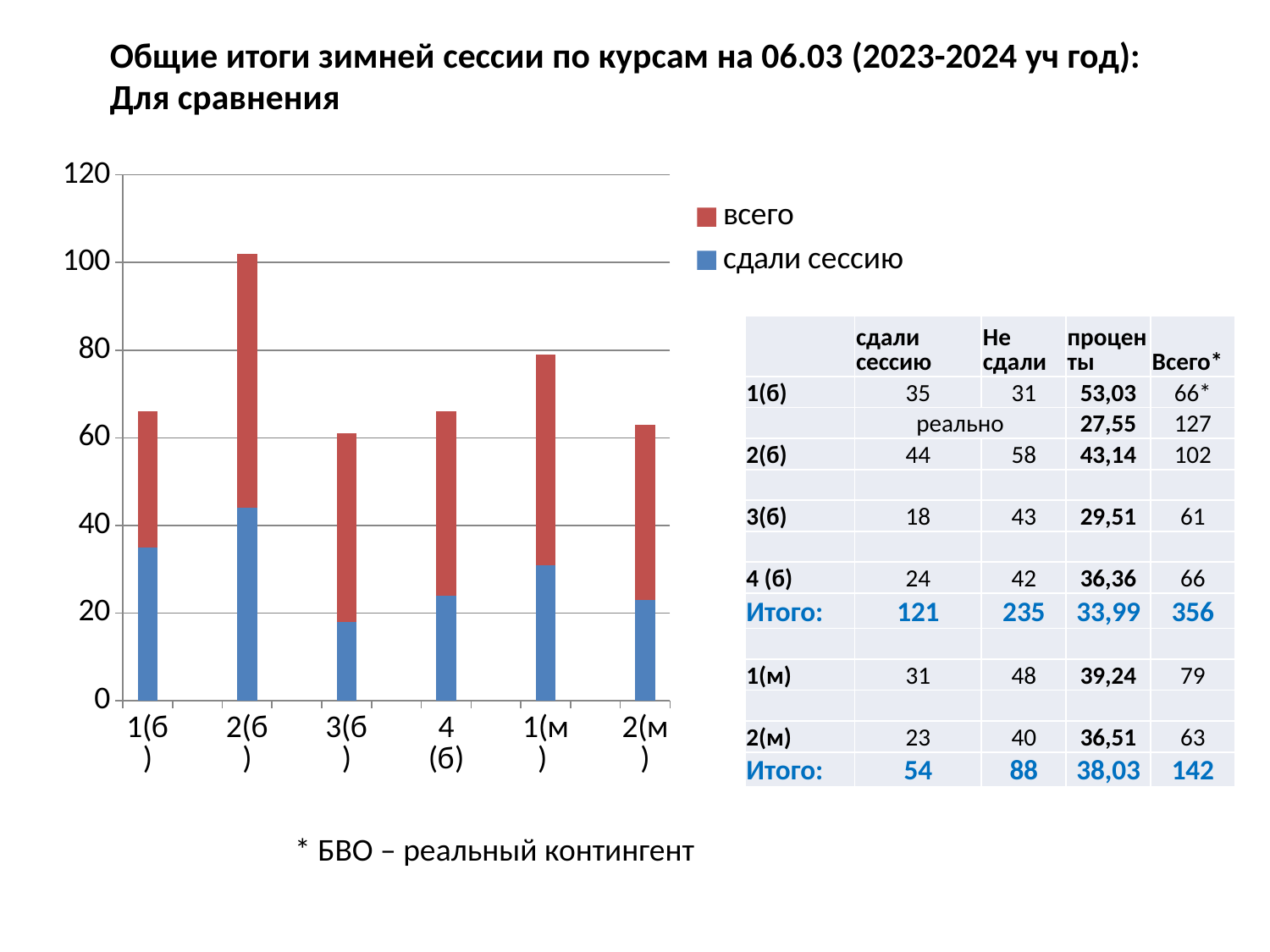
Which category has the highest value for сдали сессию? 2(б) Is the value for всего for 3(б) greater or less than 80? less Which is larger, the сдали сессию value for 1(б) or for 4 (б)? 1(б) Which is larger, the всего value for 1(м) or for 4 (б)? 1(м) Which category has the highest value for всего? 2(б) What colour are the bars for the series всего? red What kind of chart is shown on the slide? bar chart How many series does the chart legend list? 2 What are the two entries in the chart legend? всего, сдали сессию Is the value for сдали сессию for 2(б) greater or less than 40? greater How many categories are shown on the x axis of the chart? 6